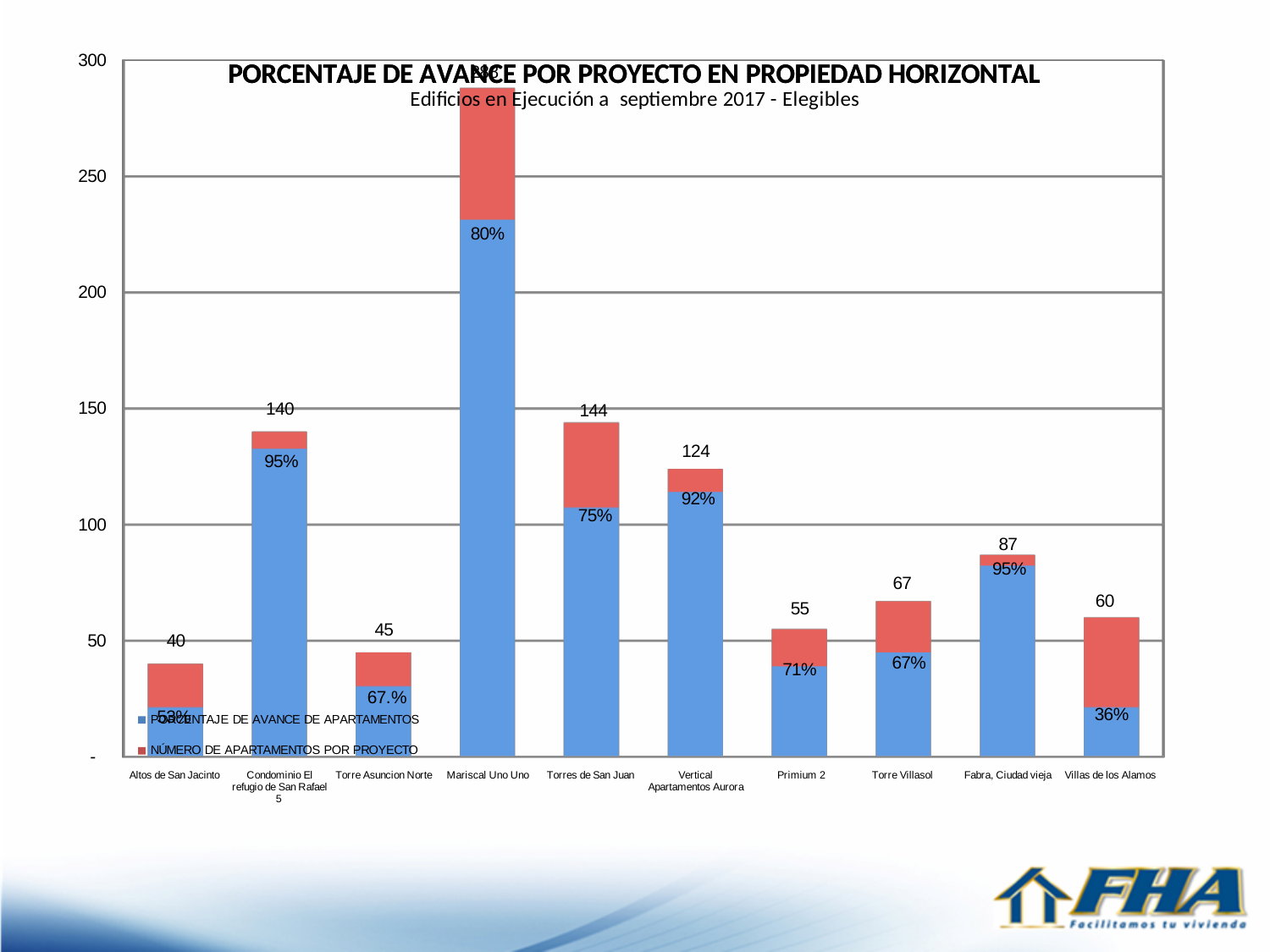
How many series does the legend list? 2 What is the percentage of progress shown for Condominio El refugio de San Rafael 5? 95% Which project has the highest number of apartments? Mariscal Uno Uno What is the percentage of progress shown for Villas de los Alamos? 36% What is the percentage of progress shown for Primium 2? 71% What is the number of apartments shown for Fabra, Ciudad vieja? 87 Which project has more apartments, Torre Villasol or Villas de los Alamos? Torre Villasol What is the difference in number of apartments between Torres de San Juan and Vertical Apartamentos Aurora? 20 How many apartments does the Torres de San Juan project have according to the chart? 144 Which project has the lowest number of apartments? Altos de San Jacinto How many projects are shown on the x axis of the chart? 10 Is the total bar height for Mariscal Uno Uno greater or less than 250? greater